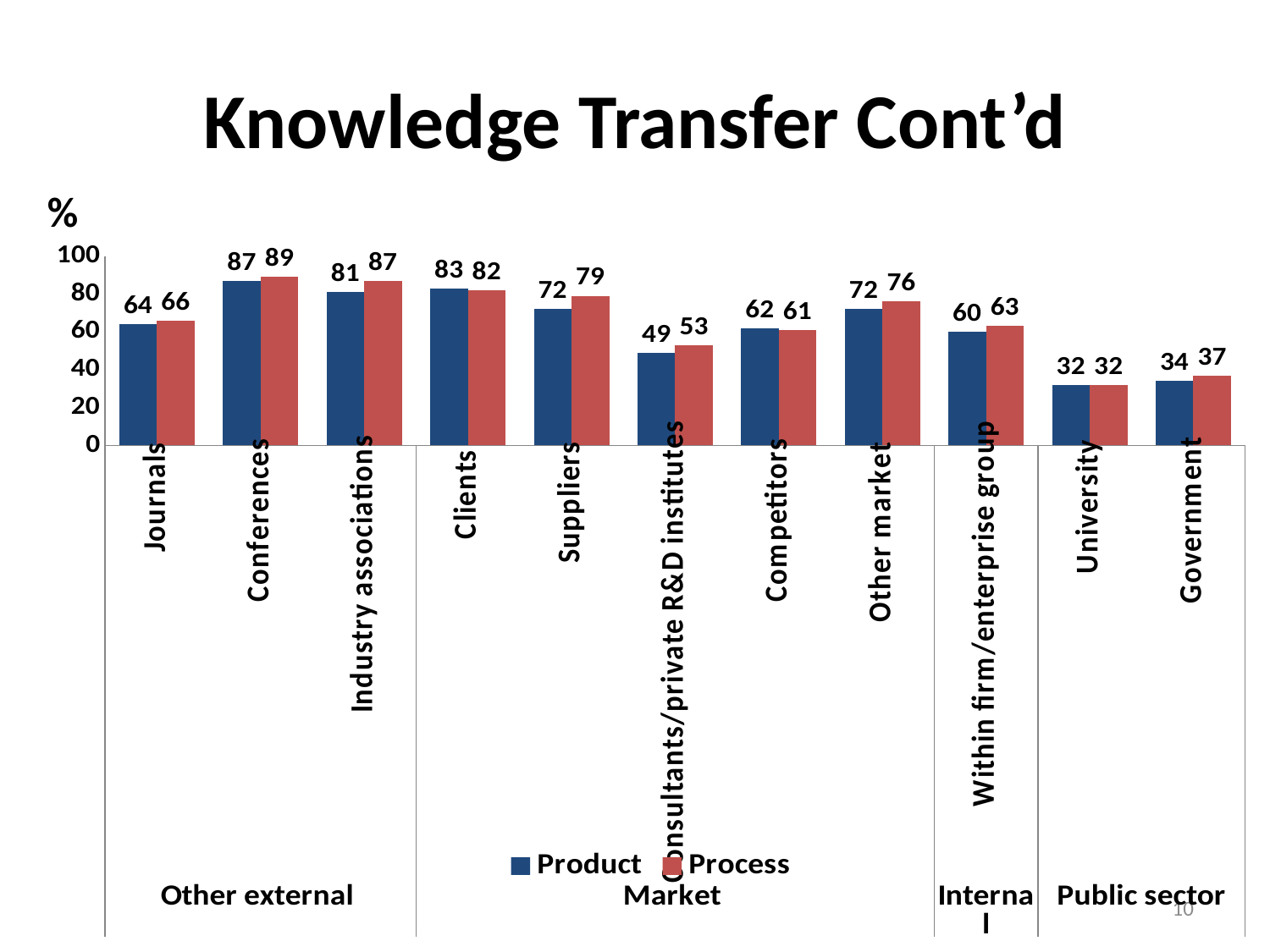
How many categories are shown on the x axis? 11 Is the Product value for Consultants/private R&D institutes greater or less than 60? less Which category has the highest Process value? Conferences What is the Process value for Suppliers? 79 What is the Product value for University? 32 What is the difference between the Process and Product values for Suppliers? 7 How many series does the legend list? 2 What kind of chart is shown on the slide? bar chart Which is larger for Competitors, the Product value or the Process value? Product Which category group on the x axis contains Clients, Suppliers and Competitors? Market What is the Product value for Conferences? 87 Which category has the lowest Product value? University